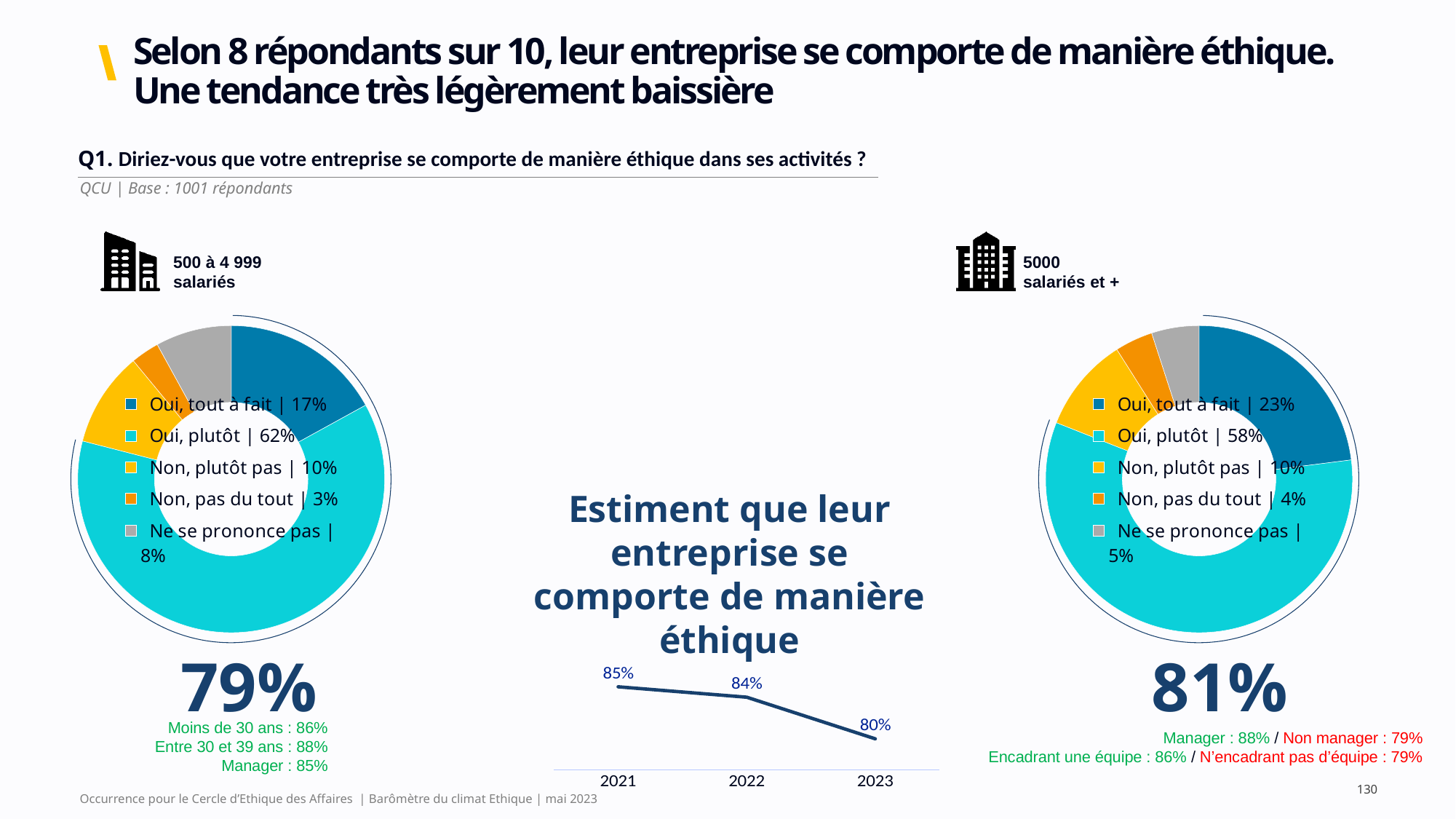
On the left donut chart (500 à 4 999 salariés), what colour is the "Ne se prononce pas" slice? Grey How many categories does the legend of the right donut chart (5000 salariés et +) list? 5 Which is larger: "Oui, tout à fait" on the left donut chart (500 à 4 999 salariés) or "Oui, tout à fait" on the right donut chart (5000 salariés et +)? Right donut chart (5000 salariés et +) What kind of chart is the chart in the centre of the slide titled "Estiment que leur entreprise se comporte de manière éthique"? Line chart On the left donut chart (500 à 4 999 salariés), which category has the largest share? Oui, plutôt On the centre line chart "Estiment que leur entreprise se comporte de manière éthique", do the values rise or fall from 2021 to 2023? Fall On the centre line chart "Estiment que leur entreprise se comporte de manière éthique", what is the value for 2022? 84% On the left donut chart (500 à 4 999 salariés), which category has the smallest share? Non, pas du tout On the right donut chart (5000 salariés et +), what is the difference between "Oui, plutôt" and "Oui, tout à fait"? 35% On the right donut chart (5000 salariés et +), what is the value for "Oui, tout à fait"? 23% On the left donut chart (500 à 4 999 salariés), what is the value for "Oui, plutôt"? 62% On the centre line chart "Estiment que leur entreprise se comporte de manière éthique", what is the difference between the 2021 and 2023 values? 5%